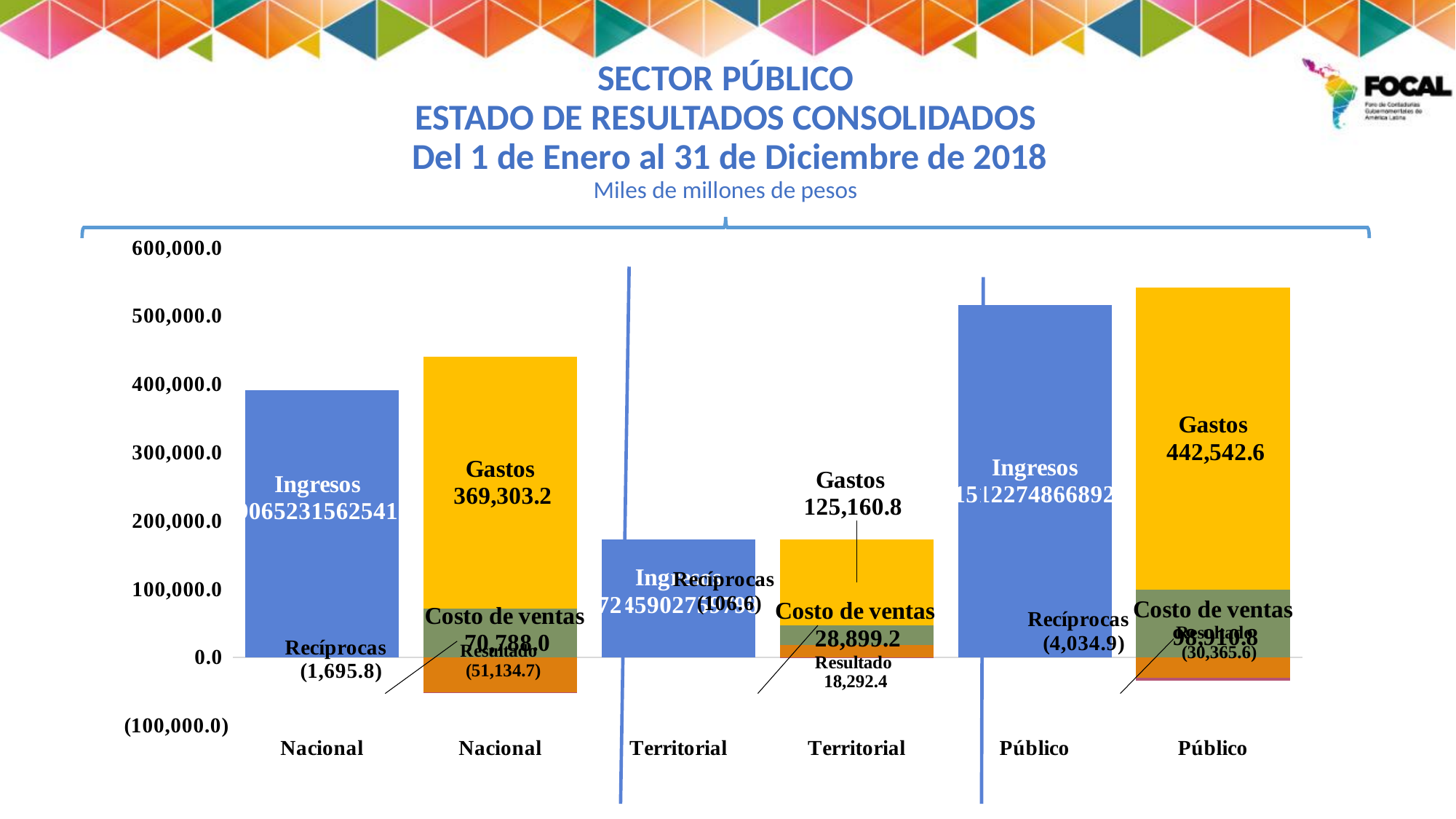
What is the value of Resultado for the Territorial sector? 18,292.4 Is the Ingresos bar for the Territorial sector greater or less than 200,000.0? less What is the value of Recíprocas for the Público sector? (4,034.9) What is the difference between the Gastos values for Público and Nacional? 73,239.4 What is the value of Resultado for the Nacional sector? (51,134.7) What is the value of Gastos for the Público sector? 442,542.6 What is the value of Gastos for the Territorial sector? 125,160.8 What kind of chart is shown on the slide? bar chart What is the value of Costo de ventas for the Nacional sector? 70,788.0 Which is larger, the Gastos value for Nacional or for Territorial? Nacional Which sector has the highest Gastos value? Público What is the value of Gastos for the Nacional sector? 369,303.2